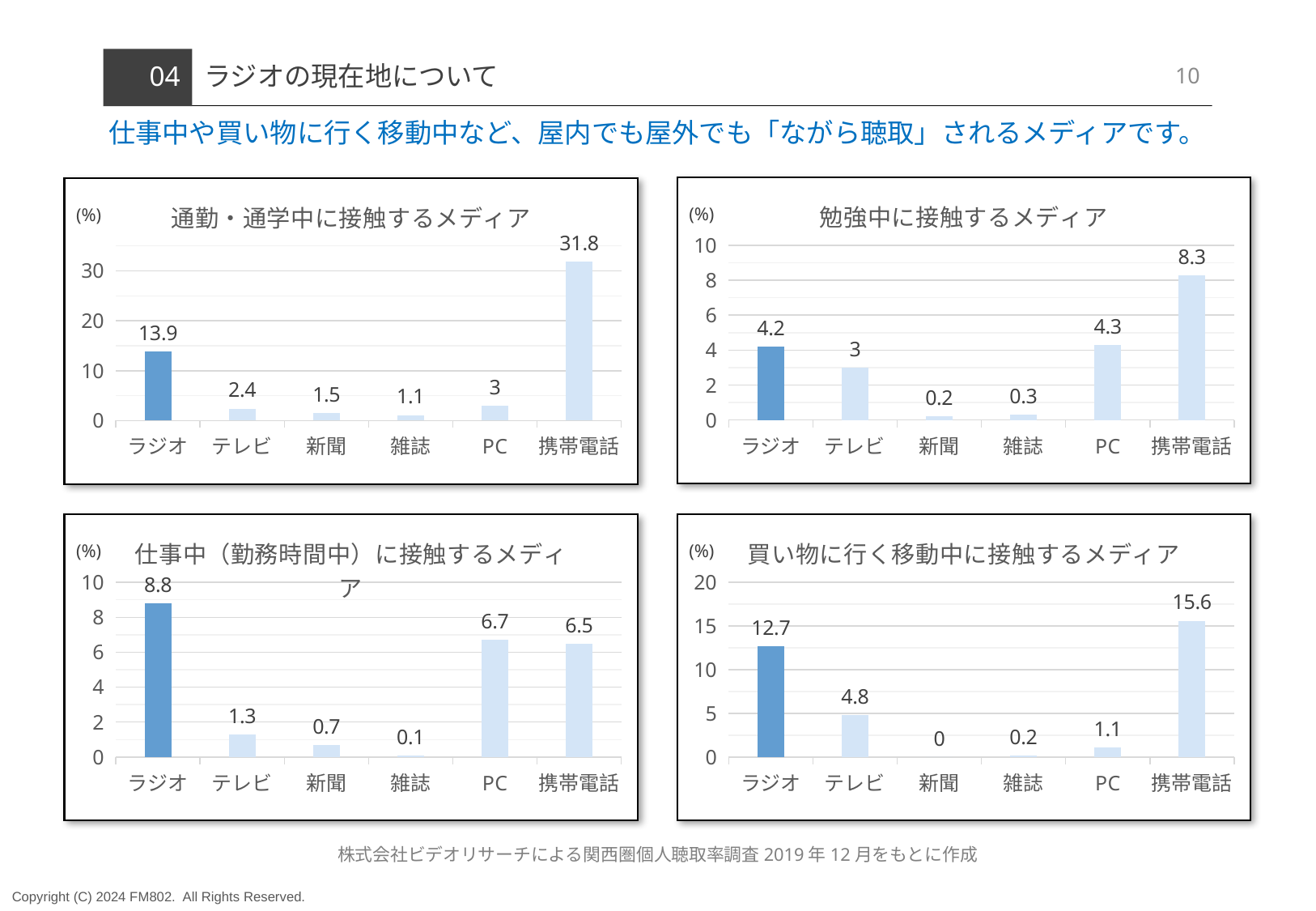
In the chart titled 仕事中（勤務時間中）に接触するメディア, which is larger, PC or 携帯電話? PC In the chart titled 買い物に行く移動中に接触するメディア, what is the difference between 携帯電話 and ラジオ? 2.9 How many categories are shown in the chart titled 買い物に行く移動中に接触するメディア? 6 In the chart titled 通勤・通学中に接触するメディア, what is the difference between 携帯電話 and ラジオ? 17.9 In the chart titled 勉強中に接触するメディア, which category has the lowest value? 新聞 In the chart titled 通勤・通学中に接触するメディア, which category has the highest value? 携帯電話 In the chart titled 通勤・通学中に接触するメディア, what is the value for ラジオ? 13.9 In the chart titled 買い物に行く移動中に接触するメディア, what is the value for テレビ? 4.8 In the chart titled 勉強中に接触するメディア, what is the value for PC? 4.3 In the chart titled 仕事中（勤務時間中）に接触するメディア, which category has the highest value? ラジオ In the chart titled 仕事中（勤務時間中）に接触するメディア, what is the value for 携帯電話? 6.5 What kind of chart is the chart titled 勉強中に接触するメディア? bar chart